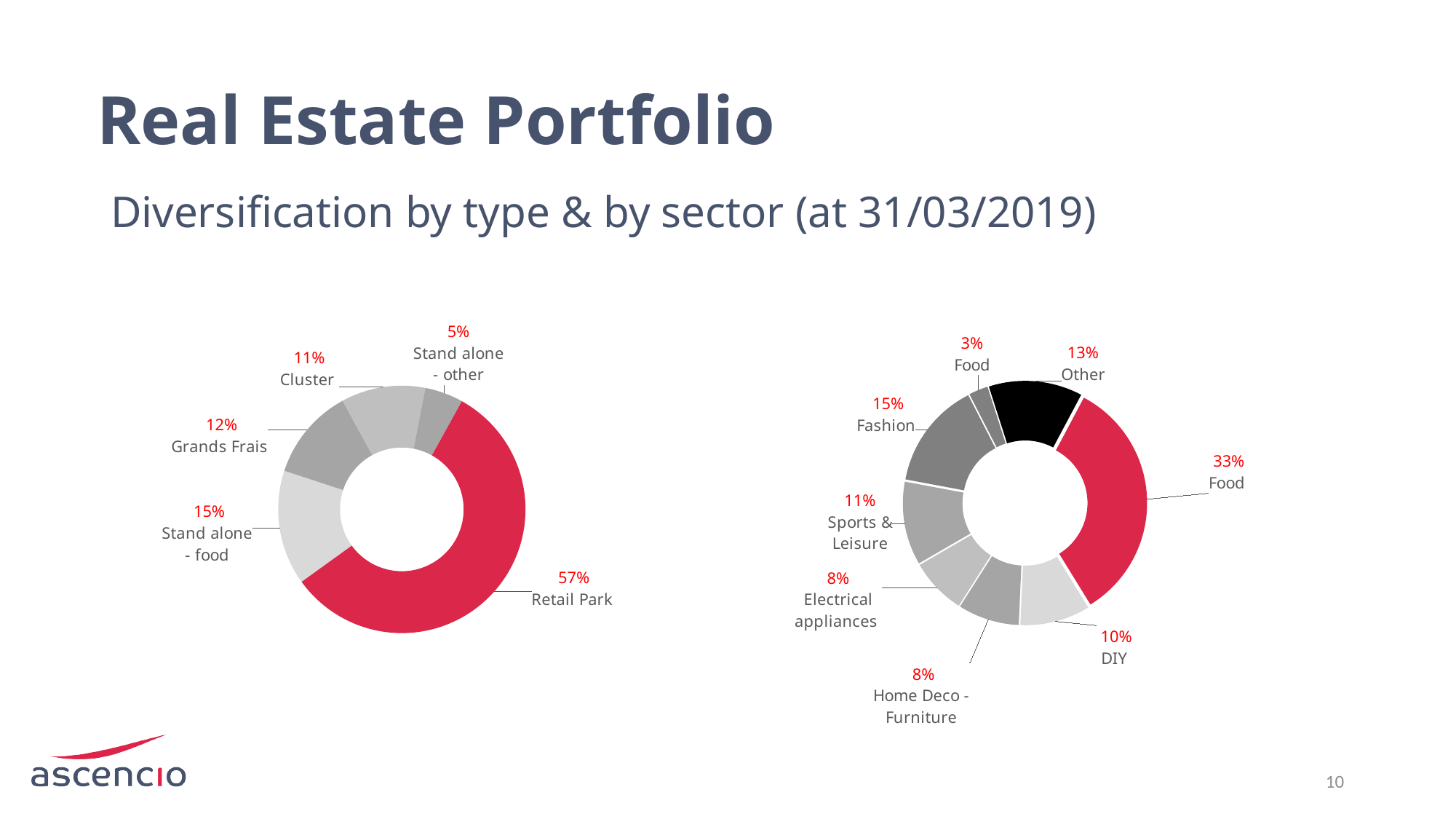
In the left chart, which is larger: Cluster or Grands Frais? Grands Frais In the left chart, what share does Grands Frais have? 12% In the left chart, which category has the smallest share? Stand alone - other What type of chart is used on this slide? Donut (pie) chart In the left chart, what is the difference in percentage points between Retail Park and Stand alone - food? 42 How many categories are shown in the left chart? 5 In the right chart, what share does DIY have? 10% In the right chart, what is the difference in percentage points between Sports & Leisure and Electrical appliances? 3 In the right chart, which category has the largest share? Food (33%) In the right chart, what share does Fashion have? 15% In the left chart, what share does Retail Park have? 57% How many categories are shown in the right chart? 8